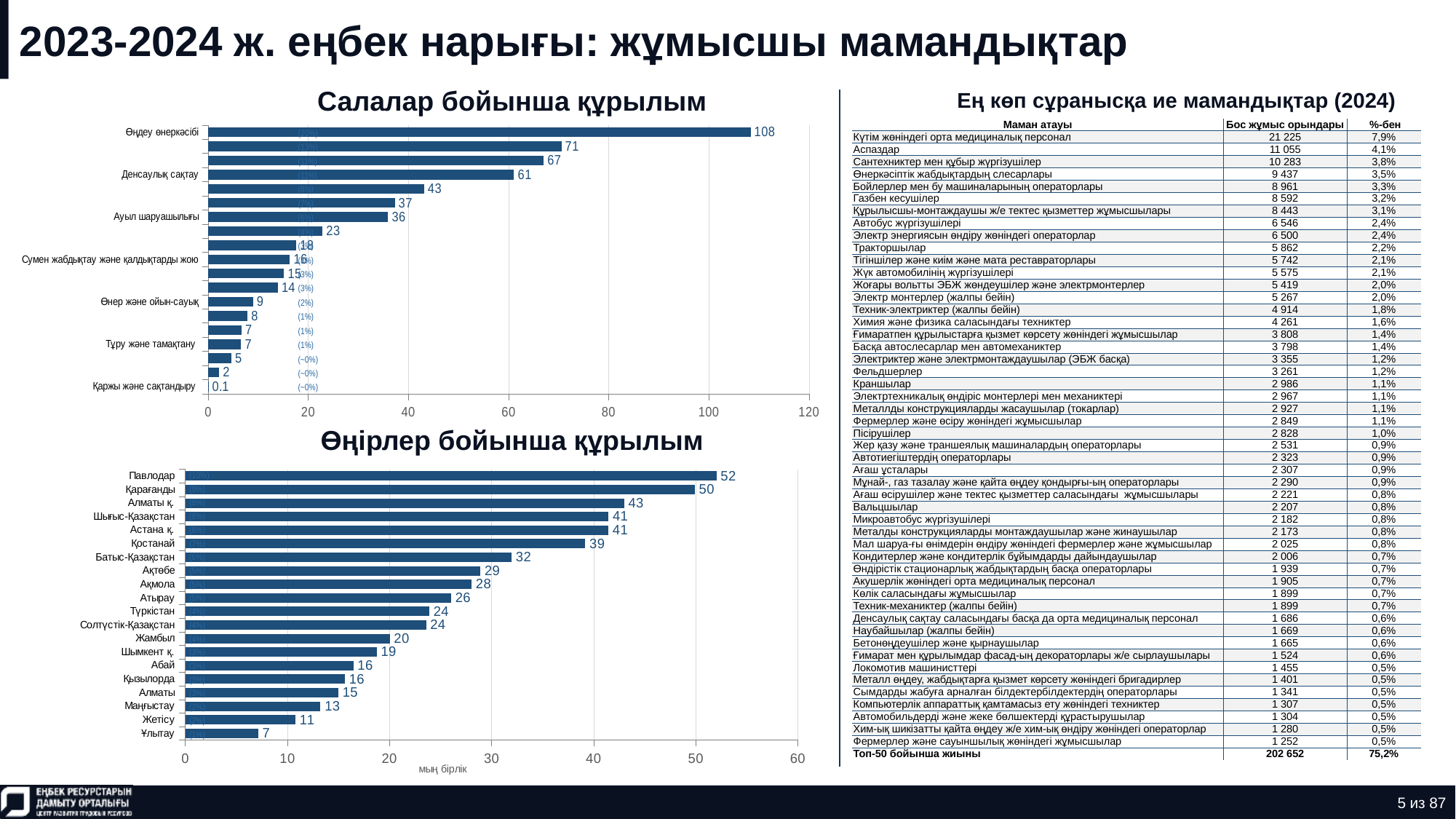
How many regions are shown in the chart 'Өңірлер бойынша құрылым'? 20 What kind of chart is 'Салалар бойынша құрылым'? Bar chart In the chart 'Өңірлер бойынша құрылым', what is the value for Павлодар? 52 In the chart 'Өңірлер бойынша құрылым', which region has the highest value? Павлодар In the chart 'Өңірлер бойынша құрылым', which is larger, the value for Ақтөбе or the value for Атырау? Ақтөбе In the chart 'Өңірлер бойынша құрылым', what is the value for Ұлытау? 7 In the chart 'Салалар бойынша құрылым', what is the difference between the values for Өңдеу өнеркәсібі and Ауыл шаруашылығы? 72 In the chart 'Салалар бойынша құрылым', what is the value for Денсаулық сақтау? 61 In the chart 'Өңірлер бойынша құрылым', what is the difference between the values for Қарағанды and Қостанай? 11 In the chart 'Өңірлер бойынша құрылым', which region has the lowest value? Ұлытау In the chart 'Салалар бойынша құрылым', what is the value for Өңдеу өнеркәсібі? 108 In the chart 'Салалар бойынша құрылым', what is the value for Қаржы және сақтандыру? 0.1